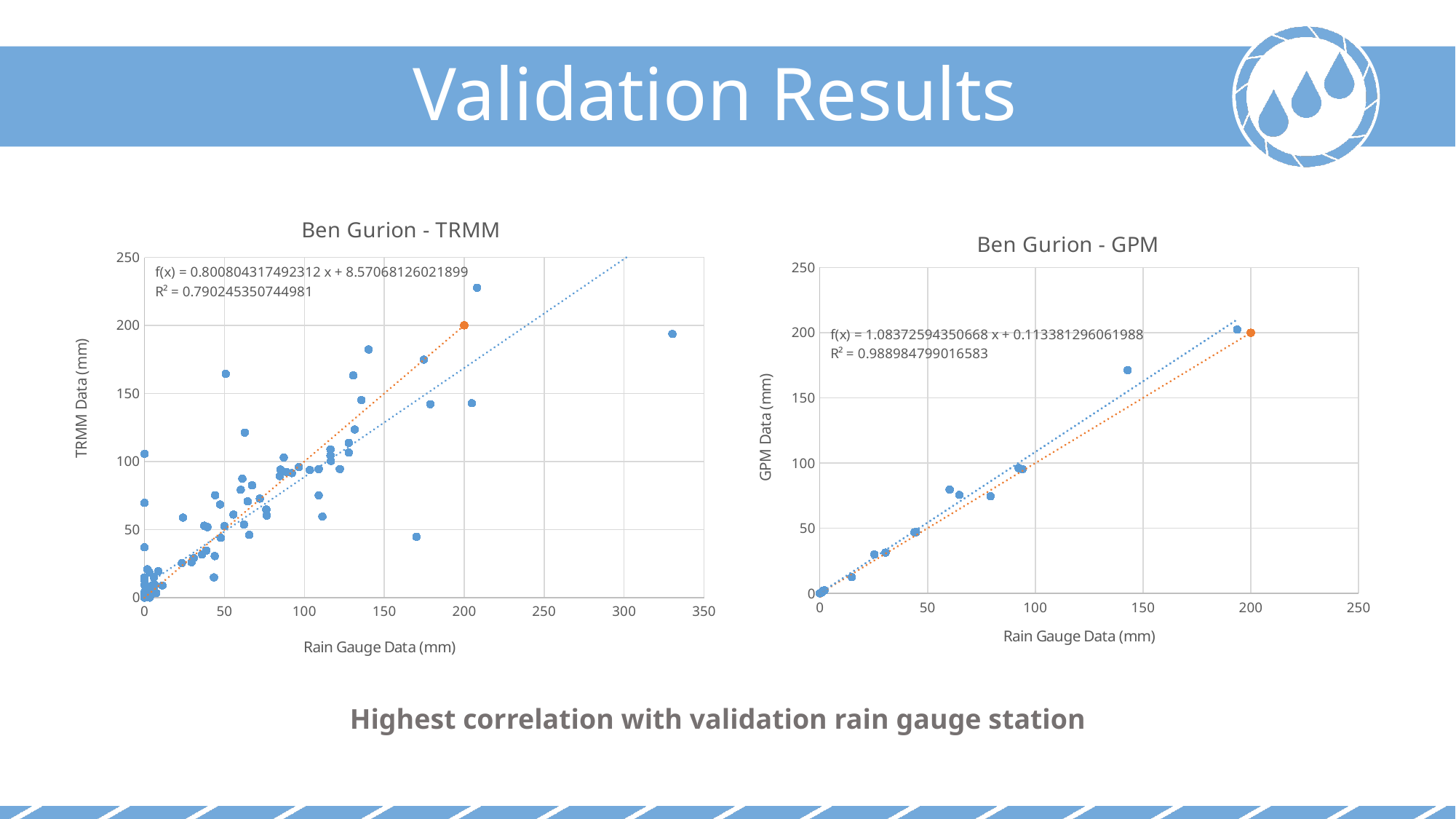
In the "Ben Gurion - GPM" chart, what is the slope of the fitted line f(x) printed on the chart? 1.08372594350668 What is the maximum value shown on the x axis of the "Ben Gurion - TRMM" chart? 350 In the "Ben Gurion - TRMM" chart, what R² value is printed on the chart? R² = 0.790245350744981 Which chart shows the higher R² value, "Ben Gurion - TRMM" or "Ben Gurion - GPM"? Ben Gurion - GPM In the "Ben Gurion - TRMM" chart, is the TRMM value of the point with the largest rain gauge value (around 330 mm) greater or less than 150? greater What kind of chart is the "Ben Gurion - TRMM" chart? scatter chart What is the title of the chart on the right side of the slide? Ben Gurion - GPM In the "Ben Gurion - GPM" chart, is the GPM value of the point at a rain gauge value of about 143 mm greater or less than 150? greater In the "Ben Gurion - TRMM" chart, what is the intercept of the fitted line f(x) printed on the chart? 8.57068126021899 In the "Ben Gurion - TRMM" chart, what is the label of the y axis? TRMM Data (mm) In the "Ben Gurion - GPM" chart, do the GPM values generally rise or fall as the rain gauge values increase? rise In the "Ben Gurion - GPM" chart, what R² value is printed on the chart? R² = 0.988984799016583